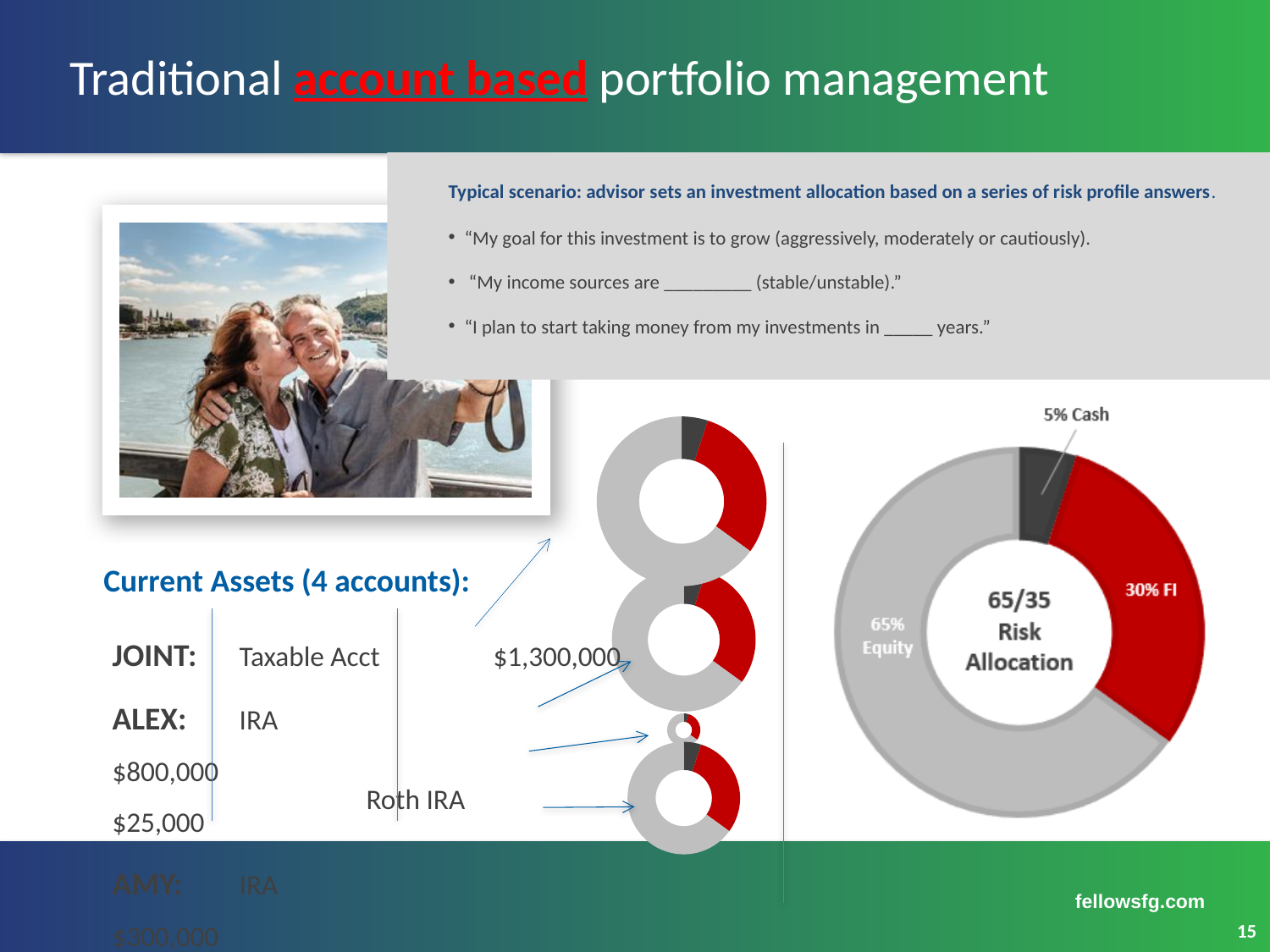
In the 65/35 Risk Allocation chart, what is the difference in percentage points between the FI share and the Cash share? 25 In the 65/35 Risk Allocation chart, what colour is the FI slice? Red In the 65/35 Risk Allocation chart, what share of the allocation is Equity? 65% In the 65/35 Risk Allocation chart, what share of the allocation is FI? 30% In the 65/35 Risk Allocation chart, which slice is the largest? Equity In the 65/35 Risk Allocation chart, what share of the allocation is Cash? 5% In the 65/35 Risk Allocation chart, what is the difference in percentage points between the Equity share and the FI share? 35 In the 65/35 Risk Allocation chart, how many slices are there? 3 In the 65/35 Risk Allocation chart, which slice is the smallest? Cash What text is shown in the centre of the large donut chart on the right? 65/35 Risk Allocation In the 65/35 Risk Allocation chart, which is larger, the Equity slice or the FI slice? Equity What kind of chart is the large chart on the right of the slide? Pie (donut) chart